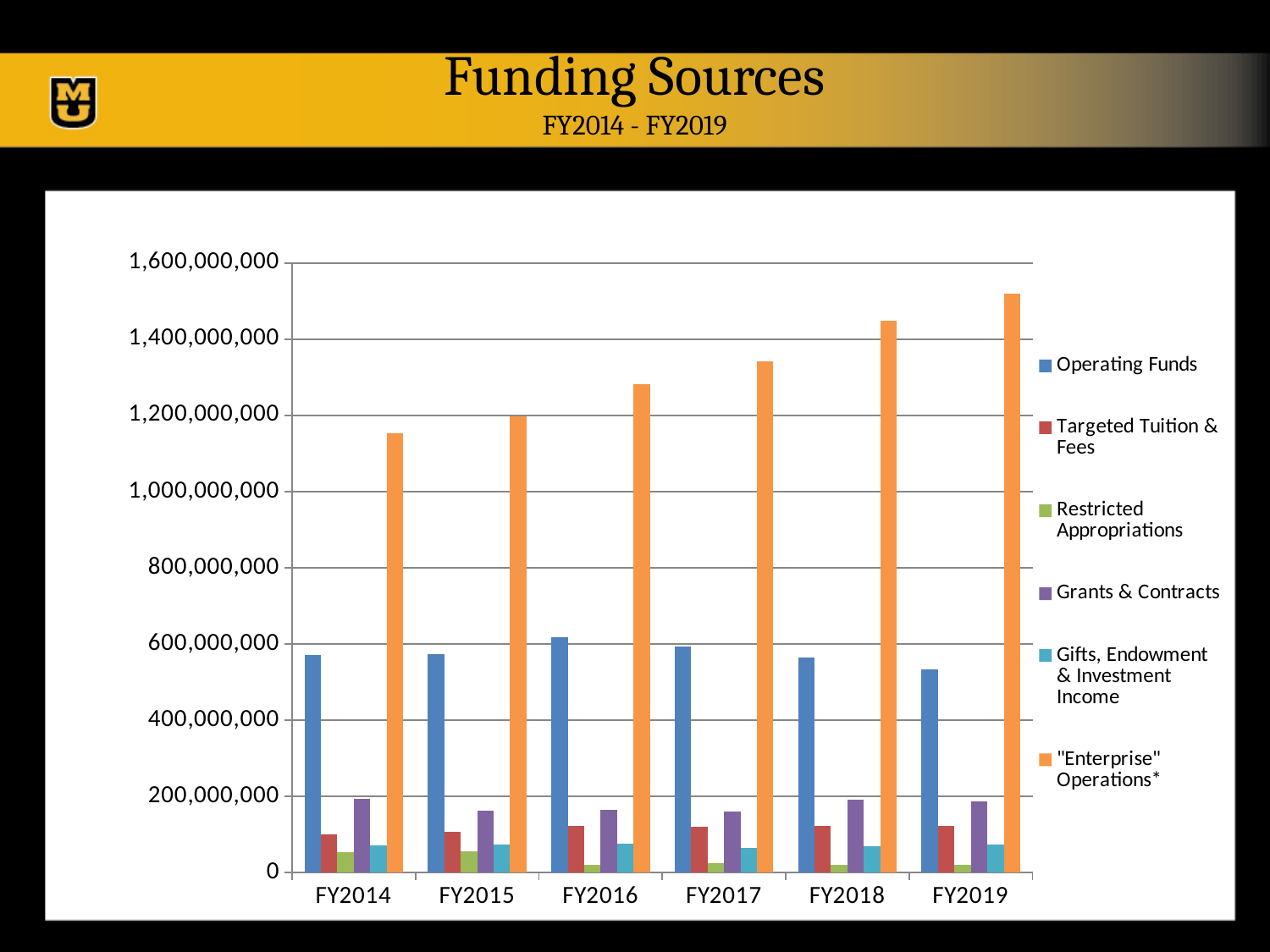
Do the "Enterprise" Operations* values rise or fall from FY2014 to FY2019? rise What kind of chart is shown on the slide? bar chart What is the title of the chart slide? Funding Sources In which fiscal year is "Enterprise" Operations* highest? FY2019 Is the value for "Enterprise" Operations* in FY2014 greater or less than 1,200,000,000? less How many series does the legend list? 6 Is the value for "Enterprise" Operations* in FY2019 greater or less than 1,400,000,000? greater In FY2014, which is larger: Operating Funds or "Enterprise" Operations*? "Enterprise" Operations* Is the value for Operating Funds in FY2019 greater or less than 600,000,000? less In which fiscal year is "Enterprise" Operations* lowest? FY2014 Which series has the lowest value in FY2019? Restricted Appropriations How many fiscal years are shown on the x axis? 6